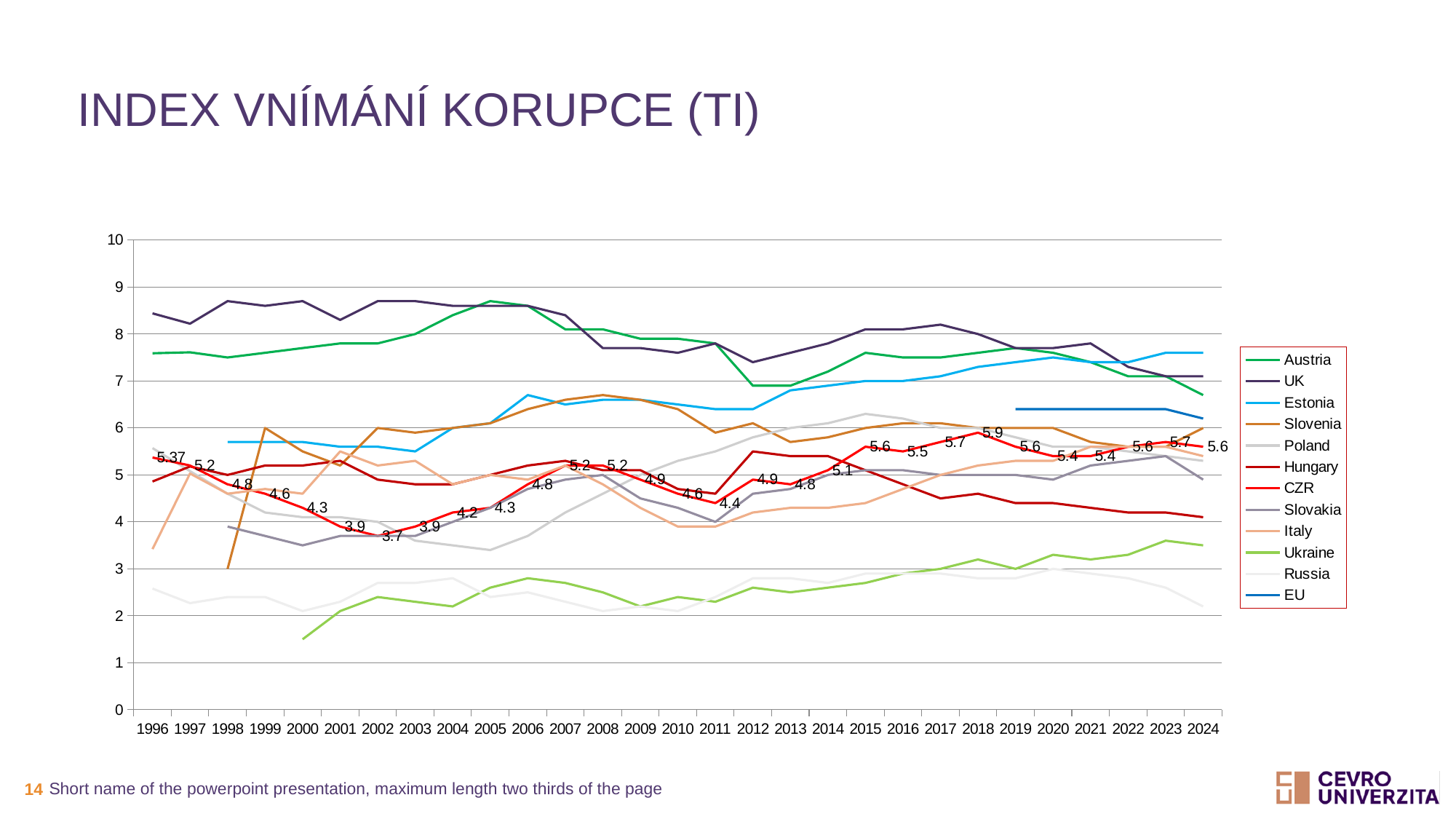
In which year does the data-labelled series reach its highest labelled value? 2018 How many years are shown on the x axis? 29 What is the labelled value of the data-labelled series in 2002? 3.7 What is the title of the chart? INDEX VNÍMÁNÍ KORUPCE (TI) For the data-labelled series, which year has the larger labelled value, 1996 or 2024? 2024 In which year does the data-labelled series reach its lowest labelled value? 2002 What is the labelled value of the data-labelled series in 2018? 5.9 Is the value for Ukraine in 2000 greater or less than 2? less How many series does the legend list? 12 What kind of chart is shown on the slide? line chart What is the difference between the labelled values of the data-labelled series in 2018 and 2002? 2.2 What is the labelled value of the data-labelled series in 1996? 5.37